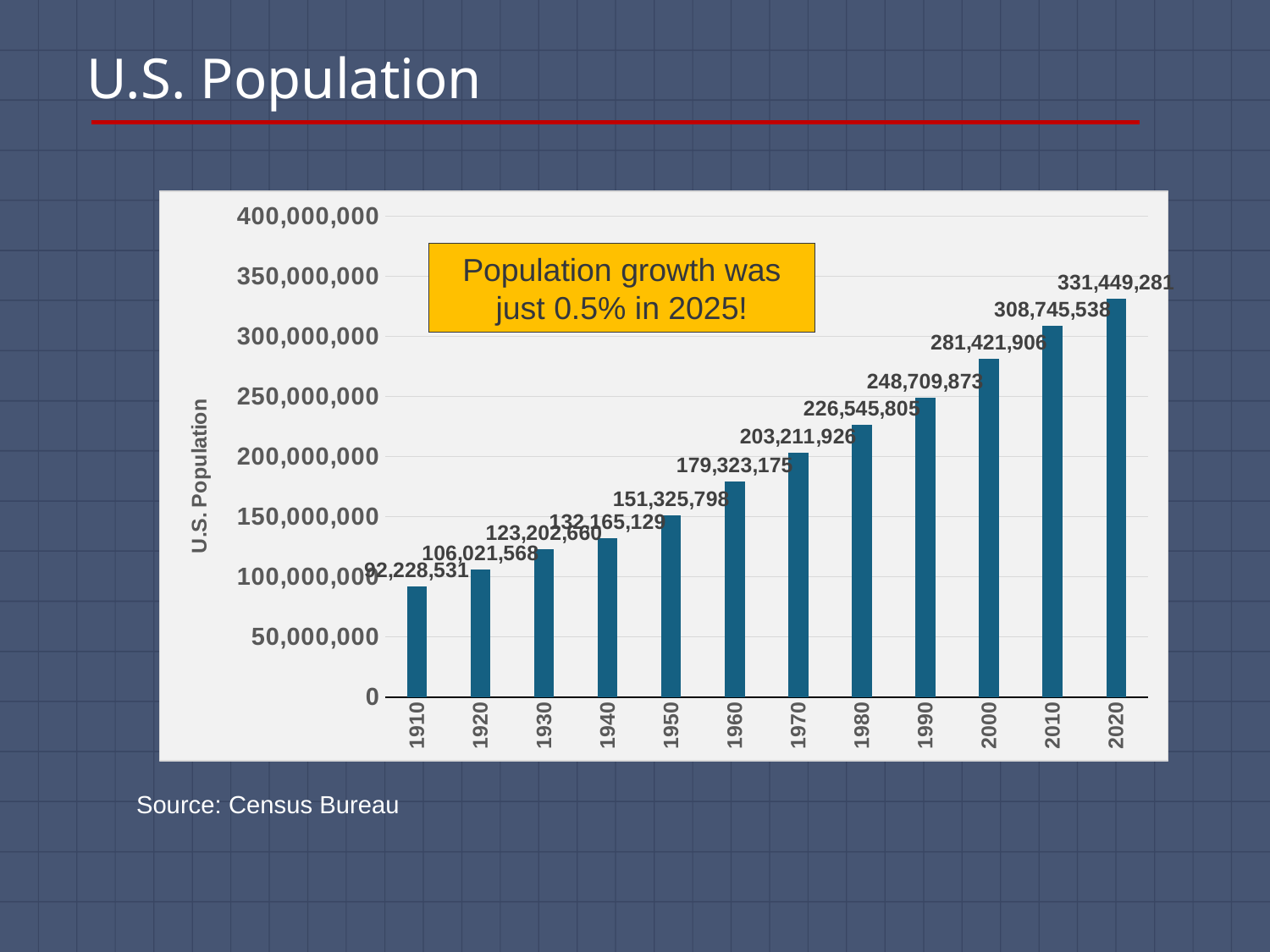
What was the U.S. population in 1990 according to the chart? 248,709,873 Does the U.S. population rise or fall from 1910 to 2020 in the chart? rise By how much did the U.S. population increase from 2010 to 2020? 22,703,743 Which year has the highest U.S. population in the chart? 2020 Which year has the lowest U.S. population in the chart? 1910 What was the U.S. population in 2020 according to the chart? 331,449,281 Which year had a larger U.S. population, 1960 or 1980? 1980 What was the U.S. population in 1950 according to the chart? 151,325,798 Is the value for 1940 greater or less than 150,000,000? less How many years (bars) are shown in the chart? 12 What type of chart is shown on the slide? bar chart What was the U.S. population in 1970 according to the chart? 203,211,926